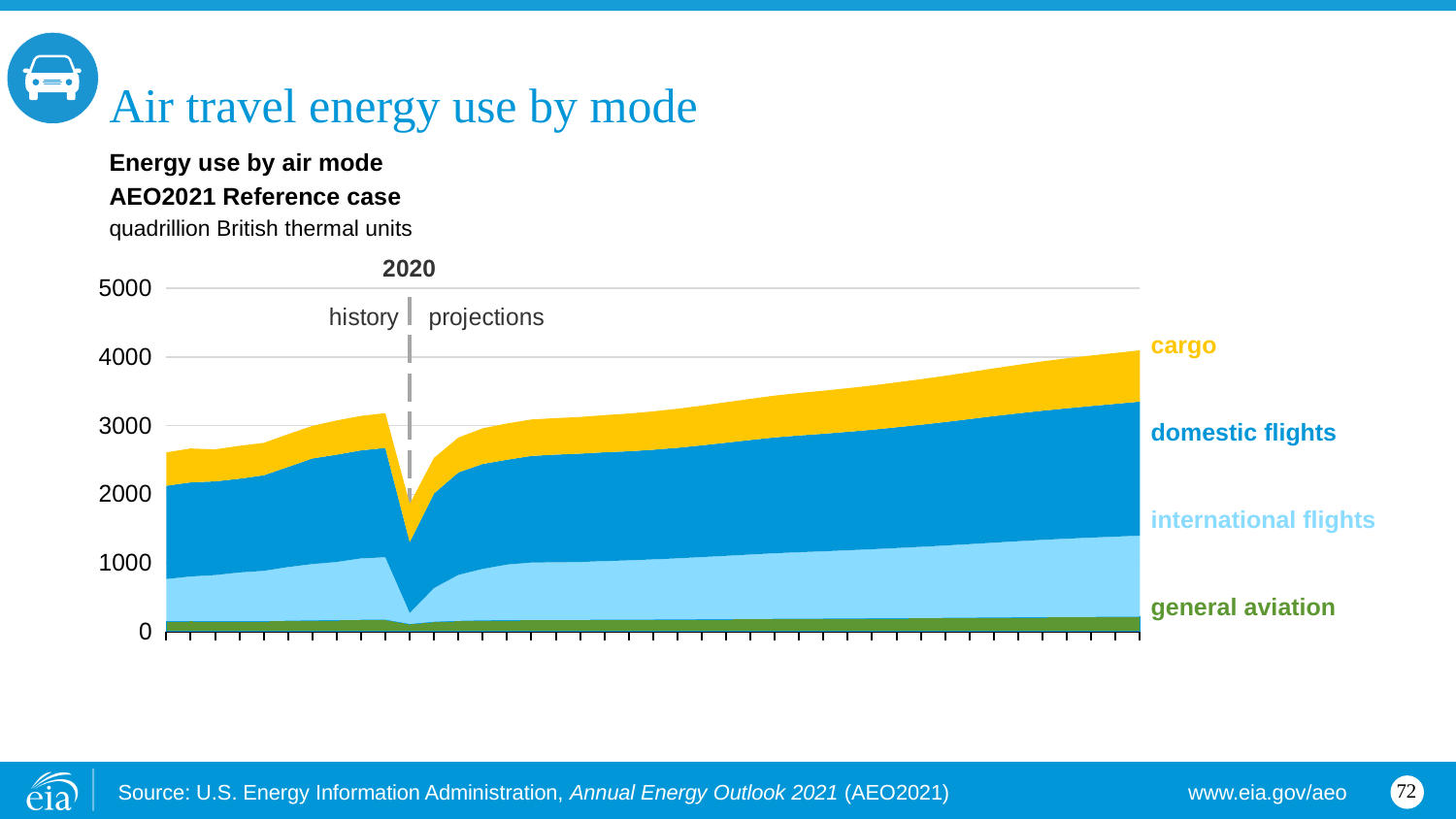
Which uses more energy in the projection period, domestic flights or international flights? domestic flights Is the total air travel energy use at the start of the history period greater or less than 3000 quadrillion Btu? less Is the total air travel energy use at the 2020 dip greater or less than 2000 quadrillion Btu? less Which air mode accounts for the smallest share of energy use across the chart? general aviation What year does the dashed vertical line separating history from projections mark? 2020 Does total air travel energy use rise or fall over the projection period after 2020? rise What unit is the y axis measured in? quadrillion British thermal units Which air mode accounts for the largest share of energy use across the chart? domestic flights How many series (air modes) does the chart show? 4 Is the total air travel energy use at the end of the projection period greater or less than 3000 quadrillion Btu? greater What kind of chart is shown on the slide? stacked area chart